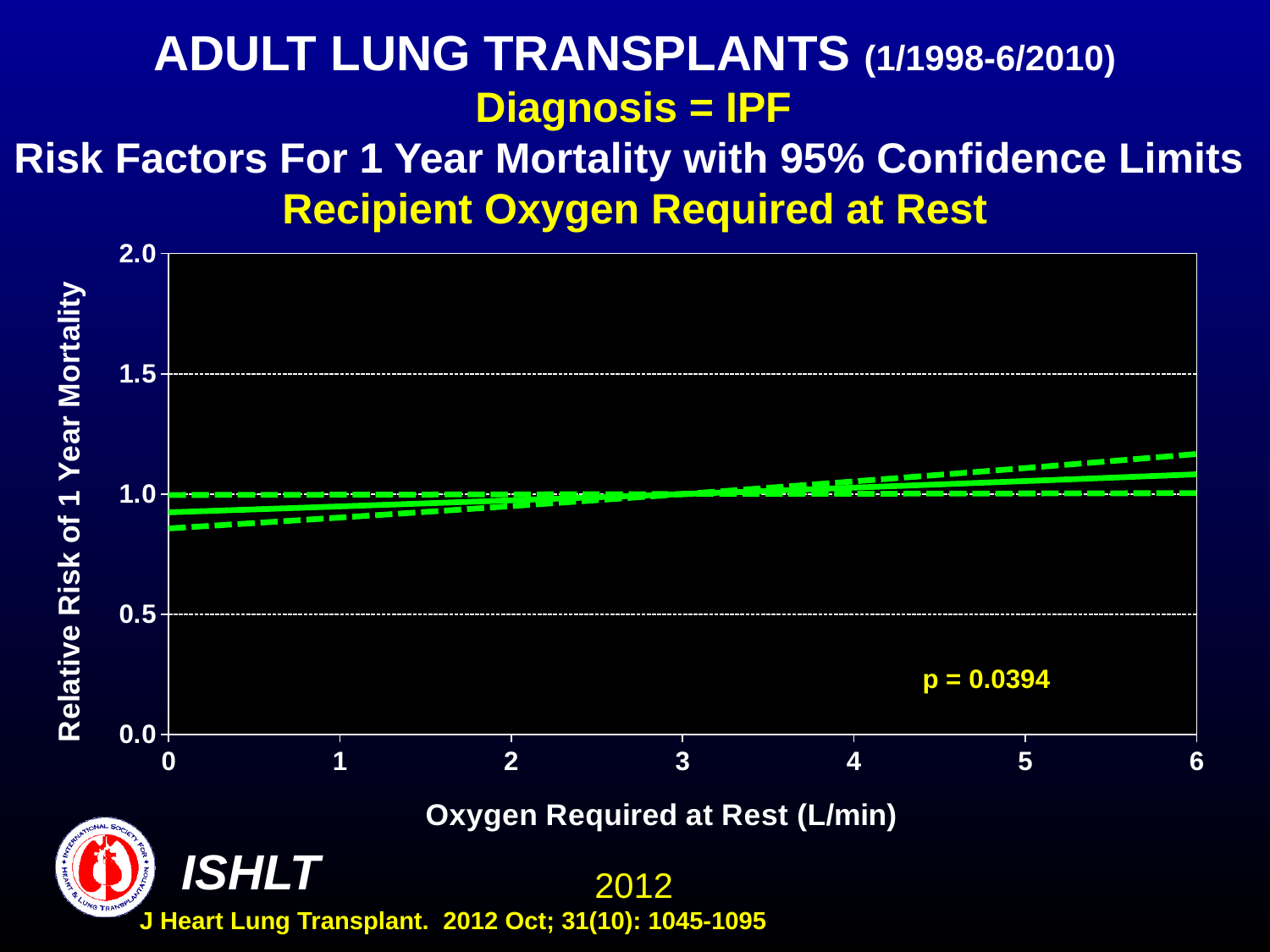
What kind of chart is shown on the slide? line chart Is the upper 95% confidence limit at 6 L/min greater or less than 1.5? less Is the relative risk of 1 year mortality at 0 L/min oxygen required at rest greater or less than 1.0? less Is the relative risk of 1 year mortality at 6 L/min oxygen required at rest greater or less than 1.0? greater What is the highest value shown on the x axis? 6 What p-value is printed on the chart? p = 0.0394 What is the highest value shown on the y axis? 2.0 What is the label of the x axis? Oxygen Required at Rest (L/min) Which is larger, the relative risk at 6 L/min or the relative risk at 0 L/min? 6 L/min Does the solid relative risk line rise or fall as oxygen required at rest increases from 0 to 6 L/min? rise